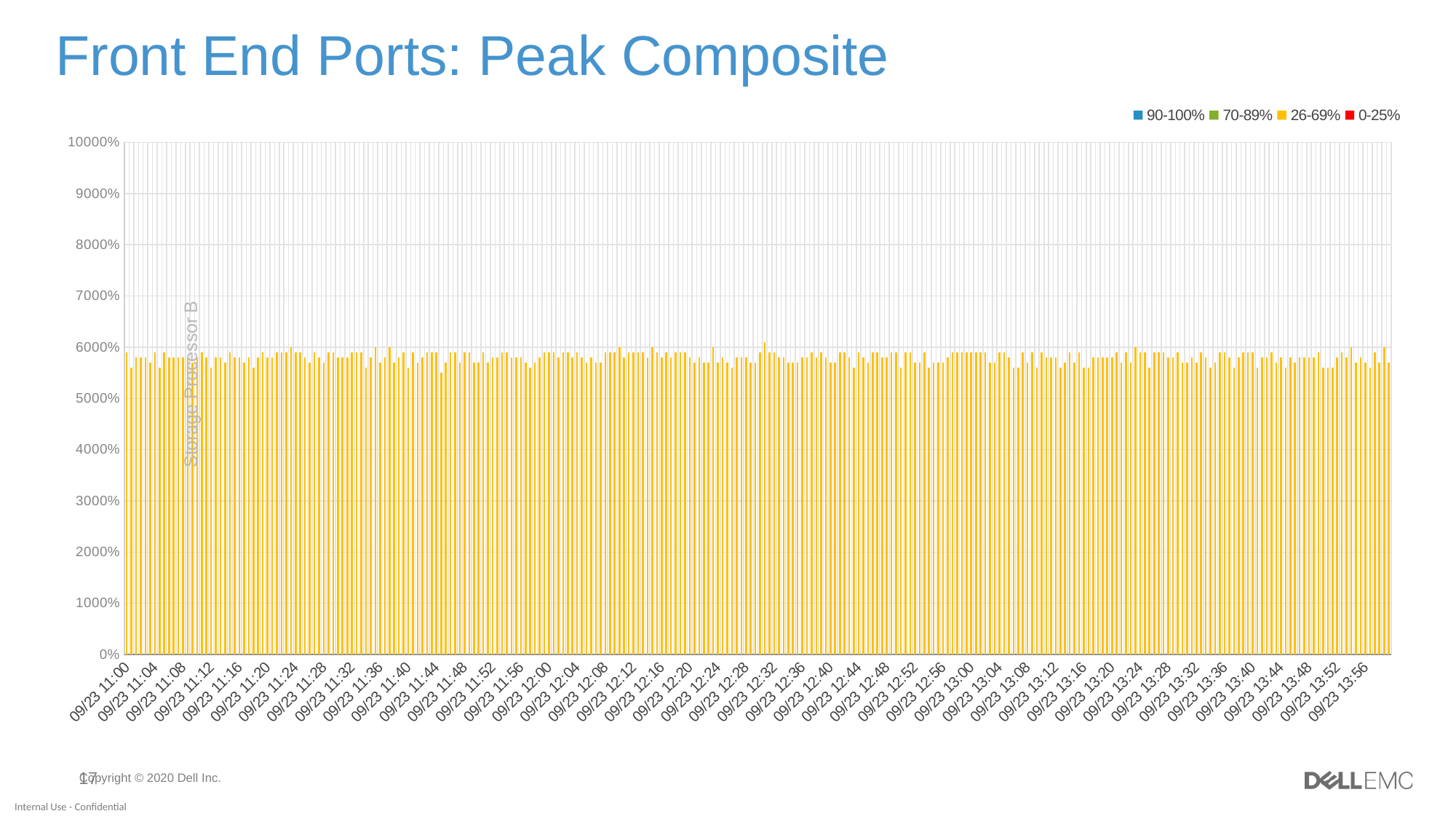
Is the value for 09/23 12:32 greater or less than 8000%? less What is the title of the chart? Front End Ports: Peak Composite Is the value for 09/23 13:20 greater or less than 4000%? greater How many series does the legend list? 4 Which legend entry do the plotted yellow bars belong to? 26-69% Do any bars reach above 7000% on the y axis? No What kind of chart is shown on the slide? bar chart Do the bar values rise, fall, or stay roughly flat from 09/23 11:00 to 09/23 13:56? roughly flat